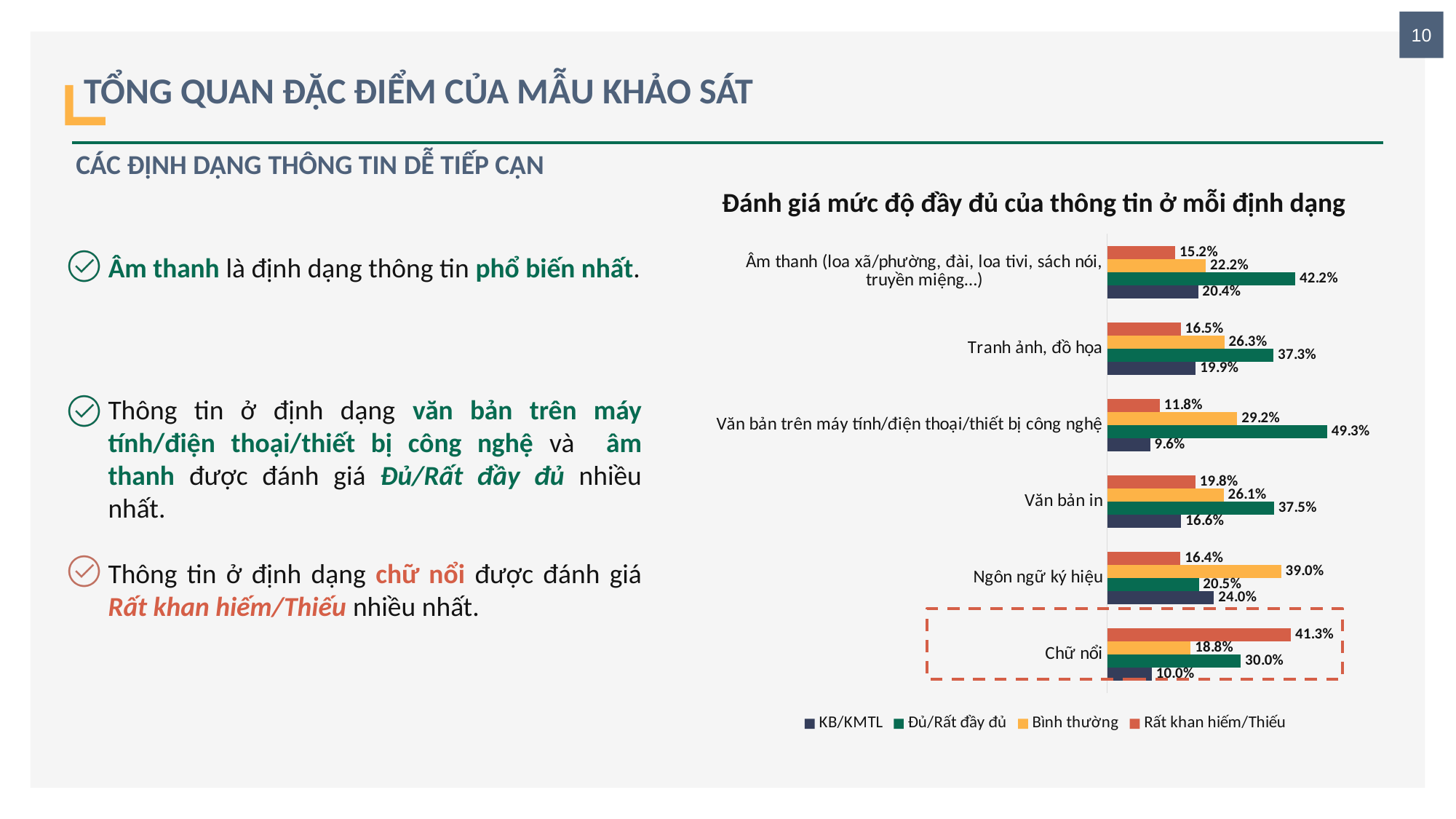
What is the Bình thường value for Ngôn ngữ ký hiệu? 39.0% What is the Rất khan hiếm/Thiếu value for Chữ nổi? 41.3% Which format has the lowest KB/KMTL value? Văn bản trên máy tính/điện thoại/thiết bị công nghệ How many series does the chart legend list? 4 What is the KB/KMTL value for Tranh ảnh, đồ họa? 19.9% Which is larger for Chữ nổi: the Rất khan hiếm/Thiếu value or the Đủ/Rất đầy đủ value? Rất khan hiếm/Thiếu How many information formats (categories) are shown in the chart? 6 What is the title of the chart? Đánh giá mức độ đầy đủ của thông tin ở mỗi định dạng Which format has the highest Đủ/Rất đầy đủ value? Văn bản trên máy tính/điện thoại/thiết bị công nghệ What is the Đủ/Rất đầy đủ value for Văn bản trên máy tính/điện thoại/thiết bị công nghệ? 49.3% What is the difference between the Đủ/Rất đầy đủ value for Âm thanh and for Văn bản in? 4.7% What kind of chart is shown on the slide? Bar chart